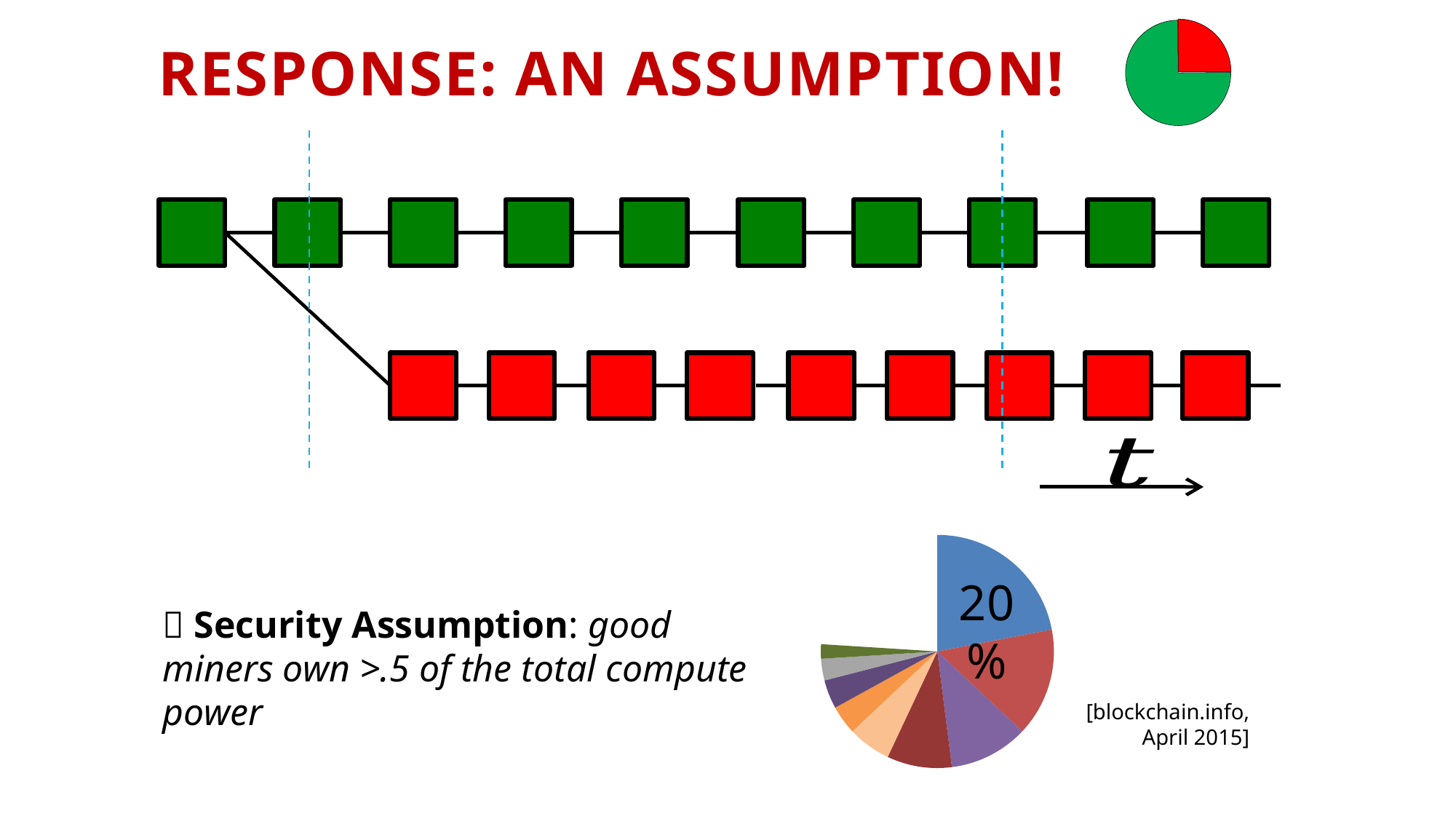
In the bottom pie chart, what share is printed on the blue slice? 20% What kind of chart is the chart at the bottom of the slide? pie chart What kind of chart is the small chart in the top-right corner of the slide? pie chart In the small pie chart in the top-right corner, which colour is the smallest slice? red In the bottom pie chart, which is larger, the blue slice or the red slice? the blue slice What colour is the slice labelled 20% in the bottom pie chart? blue In the small pie chart in the top-right corner, which slice is larger, the green one or the red one? the green slice How many slices does the small pie chart in the top-right corner have? 2 What source and date are cited next to the bottom pie chart? blockchain.info, April 2015